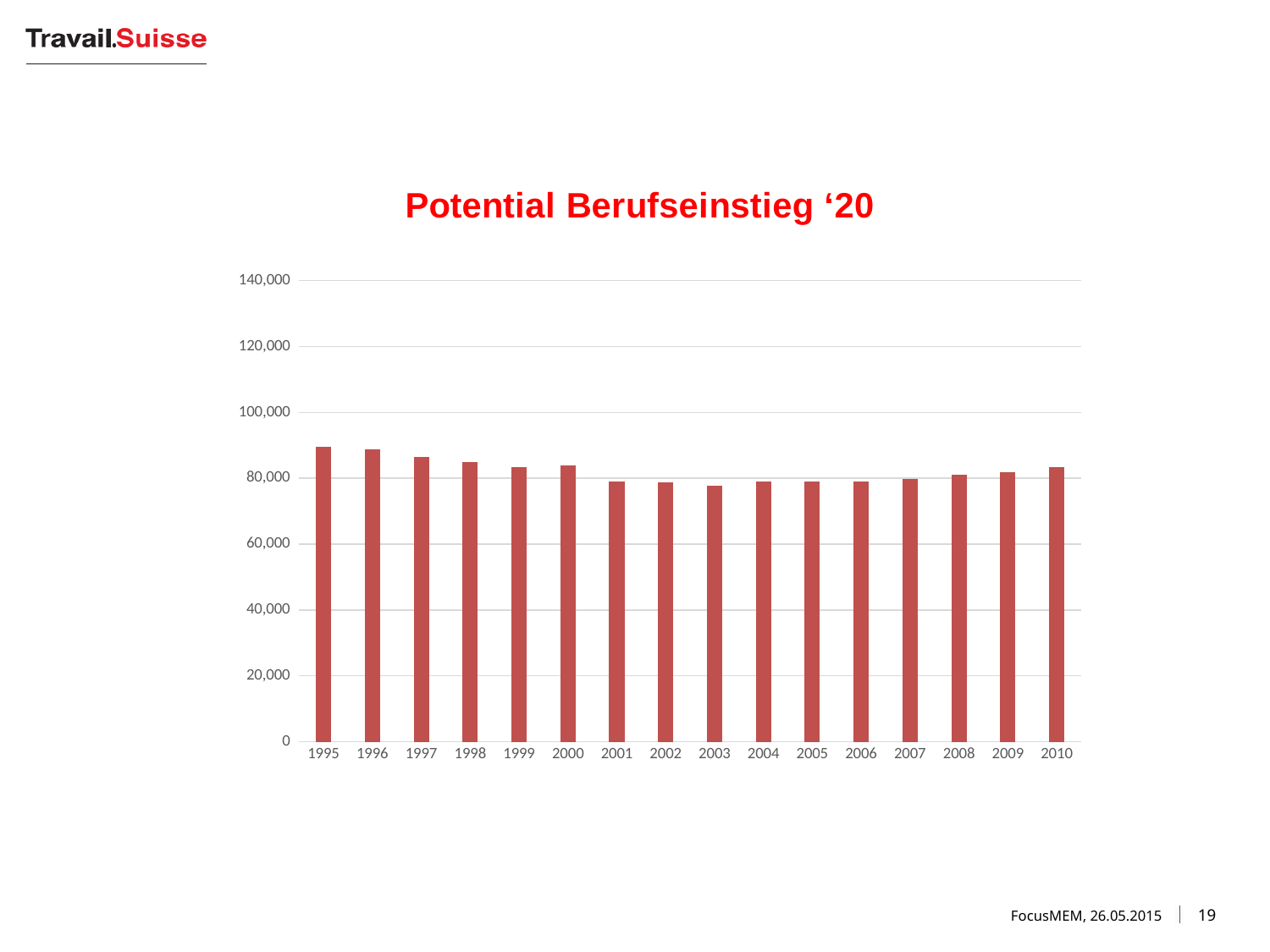
Do the values rise or fall from 1995 to 2003? fall What is the title of the chart? Potential Berufseinstieg '20 Which year has the highest value in the chart? 1995 What kind of chart is shown on the slide? Bar chart Is the value for 1997 greater or less than 100,000? less Is the value for 2003 greater or less than 80,000? less Which year has the larger value, 1997 or 2001? 1997 Which year has the larger value, 1995 or 2010? 1995 Which year has the lowest value in the chart? 2003 How many years are shown on the x axis of the chart? 16 Is the value for 1995 greater or less than 80,000? greater